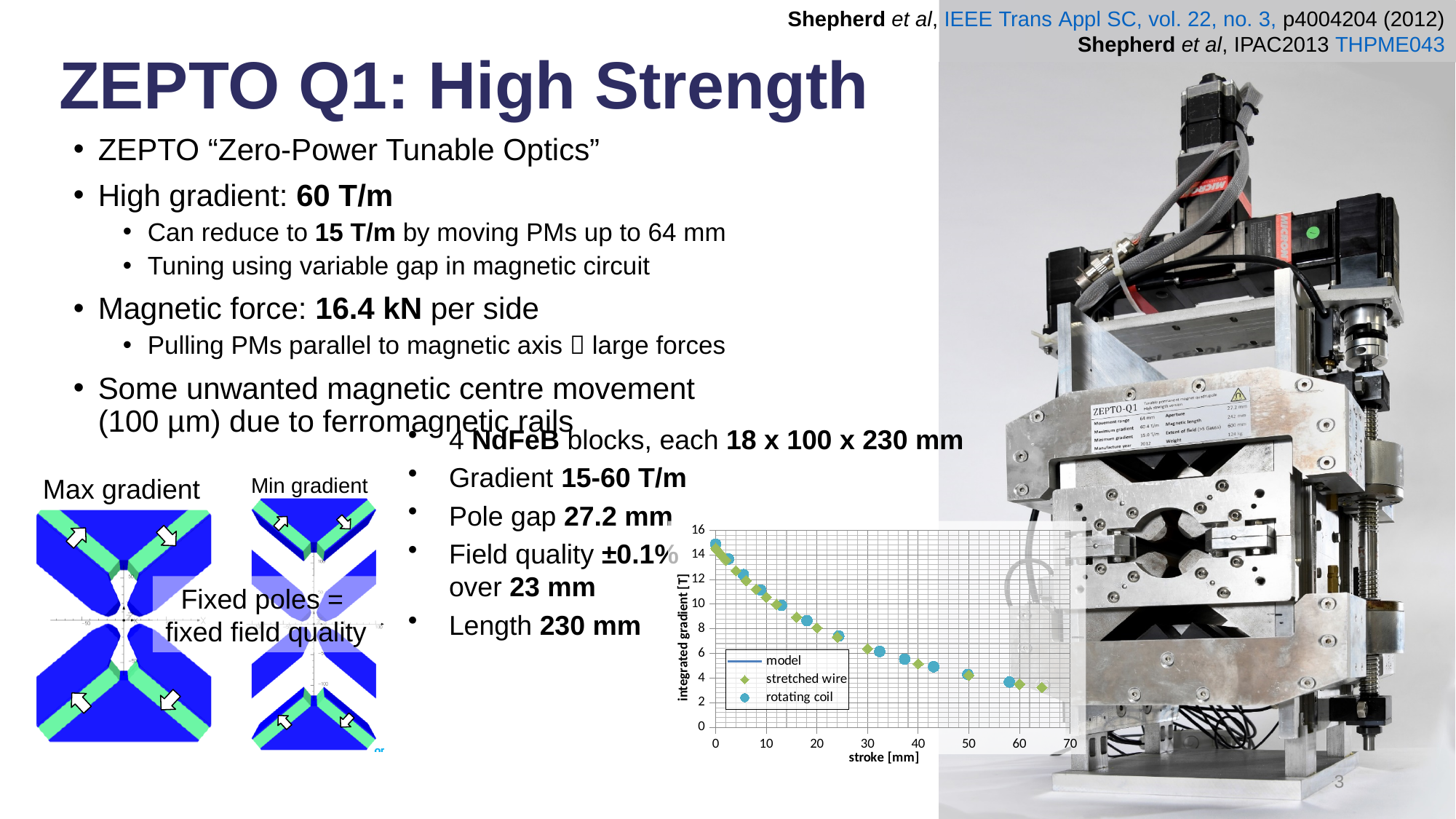
Is the integrated gradient at a stroke of 40 mm greater or less than 6 T? less What is the x-axis label of the integrated gradient chart? stroke [mm] What kind of chart is shown at the bottom of the slide (integrated gradient vs stroke)? scatter chart What is the highest tick value shown on the x axis of the integrated gradient chart? 70 Is the integrated gradient at a stroke of 0 mm greater or less than 14 T? greater Is the integrated gradient at a stroke of about 64 mm greater or less than 4 T? less Which has the larger integrated gradient: the point at stroke 0 mm or the point at stroke 60 mm? stroke 0 mm What are the three series named in the legend of the integrated gradient chart? model, stretched wire, rotating coil Does the integrated gradient rise or fall as stroke increases along the x axis? fall How many series does the legend of the integrated gradient chart list? 3